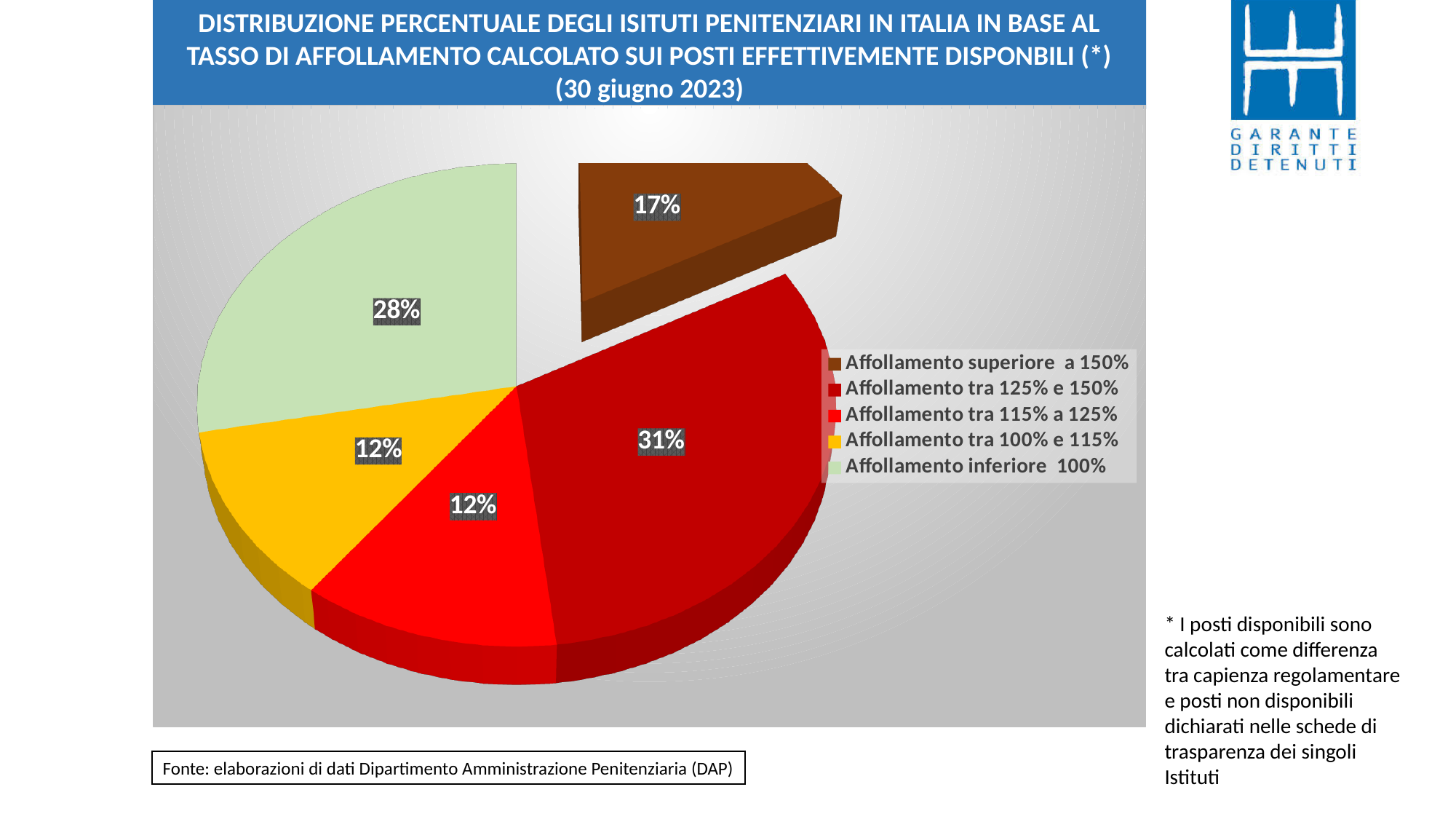
Which is larger: the share for 'Affollamento superiore a 150%' or the share for 'Affollamento inferiore 100%'? Affollamento inferiore 100% How many slices does the pie chart have? 5 What percentage of institutes have 'Affollamento inferiore 100%'? 28% What is the difference between the share for 'Affollamento tra 125% e 150%' and the share for 'Affollamento inferiore 100%'? 3% What kind of chart is shown on the slide? pie chart What percentage of institutes have 'Affollamento superiore a 150%'? 17% What colour is the slice for 'Affollamento tra 100% e 115%'? yellow What is the combined share of 'Affollamento superiore a 150%' and 'Affollamento tra 125% e 150%'? 48% What percentage of institutes have 'Affollamento tra 100% e 115%'? 12% What percentage of institutes have 'Affollamento tra 125% e 150%'? 31% What date is given in the chart title? 30 giugno 2023 Which category has the largest share of the pie? Affollamento tra 125% e 150%